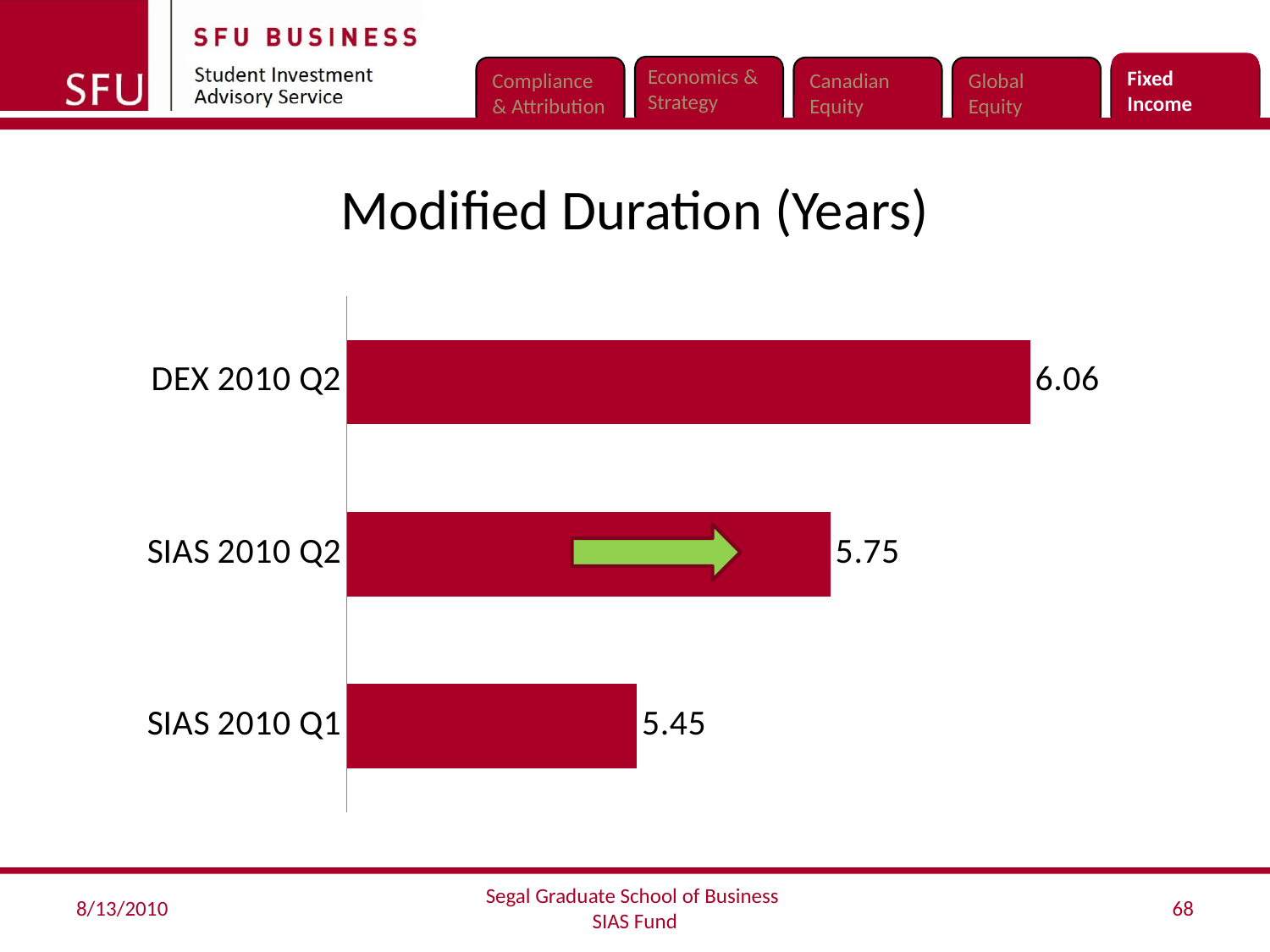
What is the difference between the modified duration of DEX 2010 Q2 and SIAS 2010 Q2? 0.31 What is the difference between the modified duration of SIAS 2010 Q2 and SIAS 2010 Q1? 0.30 What kind of chart is shown on the slide? Bar chart How many categories are shown in the chart? 3 Which is larger, the modified duration for SIAS 2010 Q2 or SIAS 2010 Q1? SIAS 2010 Q2 What is the modified duration for SIAS 2010 Q1? 5.45 What is the title of the chart? Modified Duration (Years) What is the modified duration for SIAS 2010 Q2? 5.75 Which category has the lowest modified duration? SIAS 2010 Q1 Which category has the highest modified duration? DEX 2010 Q2 What is the modified duration for DEX 2010 Q2? 6.06 What colour are the bars in the chart? Red